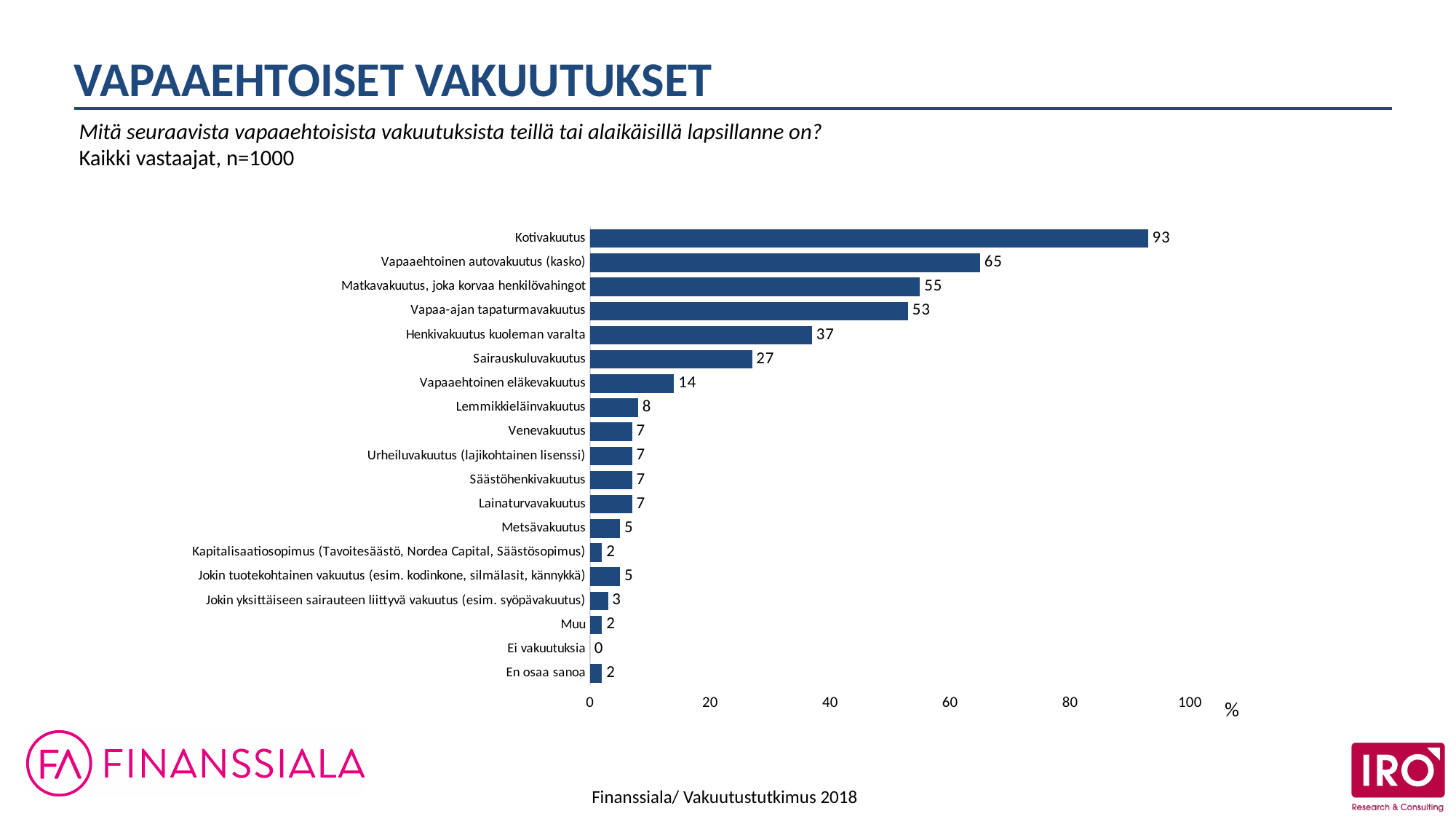
Which category has the lowest value? Ei vakuutuksia Is the value for Matkavakuutus, joka korvaa henkilövahingot greater or less than 40? greater What is the value for Vapaaehtoinen eläkevakuutus? 14 Which is larger, the value for Henkivakuutus kuoleman varalta or the value for Sairauskuluvakuutus? Henkivakuutus kuoleman varalta What is the value for Lemmikkieläinvakuutus? 8 What unit is shown at the end of the x axis? % How many categories are shown in the chart? 19 What kind of chart is shown on the slide? bar chart What is the value for Sairauskuluvakuutus? 27 What is the value for Kotivakuutus? 93 Which category has the highest value? Kotivakuutus What is the difference between the values for Kotivakuutus and Vapaaehtoinen autovakuutus (kasko)? 28